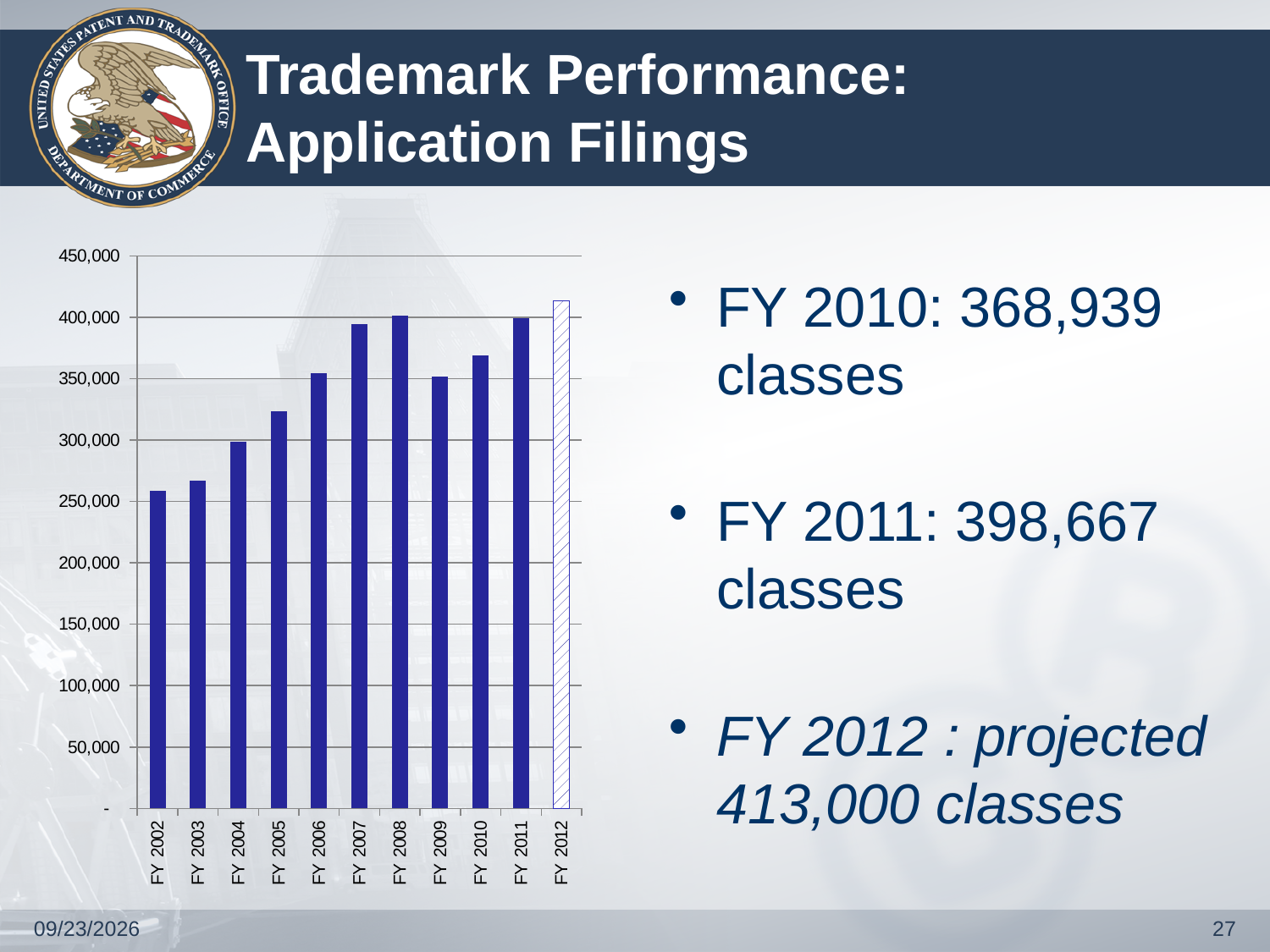
Is the value for FY 2002 greater or less than 300,000? less What is the number of classes filed in FY 2011? 398,667 How many fiscal years are plotted on the chart? 11 Do the bars rise or fall from FY 2002 to FY 2008? rise Which is larger, the bar for FY 2008 or the bar for FY 2009? FY 2008 What kind of chart is shown on the slide? bar chart Is the value for FY 2005 greater or less than 300,000? greater What is the number of classes filed in FY 2010? 368,939 Which fiscal year has the lowest bar on the chart? FY 2002 Which fiscal year has the highest bar on the chart? FY 2012 What is the projected number of classes for FY 2012? 413,000 By how many classes did filings increase from FY 2010 to FY 2011? 29,728